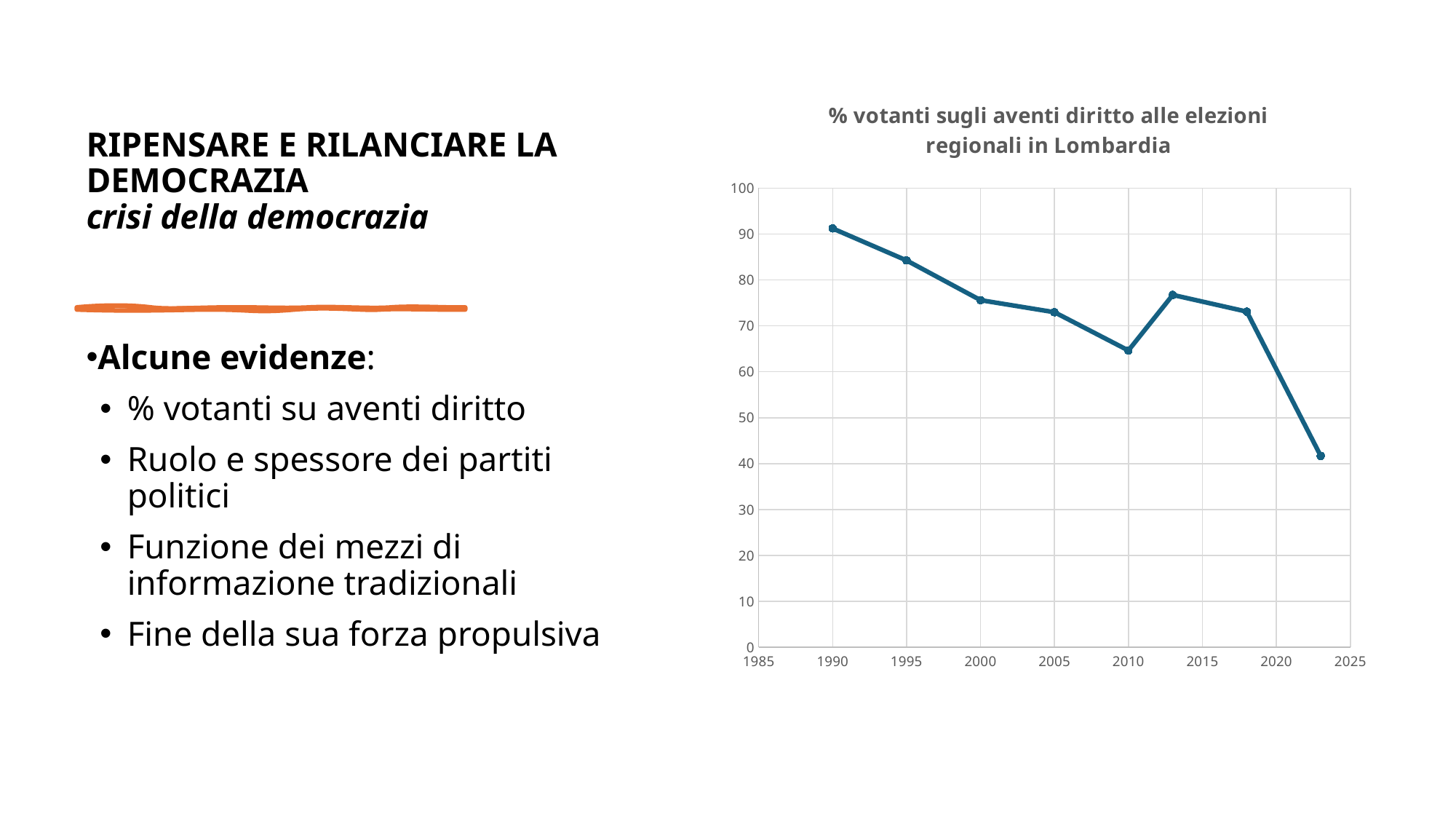
What is the title of the chart? % votanti sugli aventi diritto alle elezioni regionali in Lombardia What is the highest value shown on the y axis? 100 Which point on the line has the highest value? 1990 Is the value for 2010 greater or less than 70? less Overall, do the values rise or fall from left to right along the x axis? fall Is the value for 1995 greater or less than 80? greater How many data points are plotted on the line? 8 Is the value for 1990 greater or less than 90? greater Which is larger, the value for 2000 or the value for 2010? 2000 What kind of chart is shown on the slide? line chart Which is larger, the value for 2010 or the value of the next point after it (around 2013)? the point around 2013